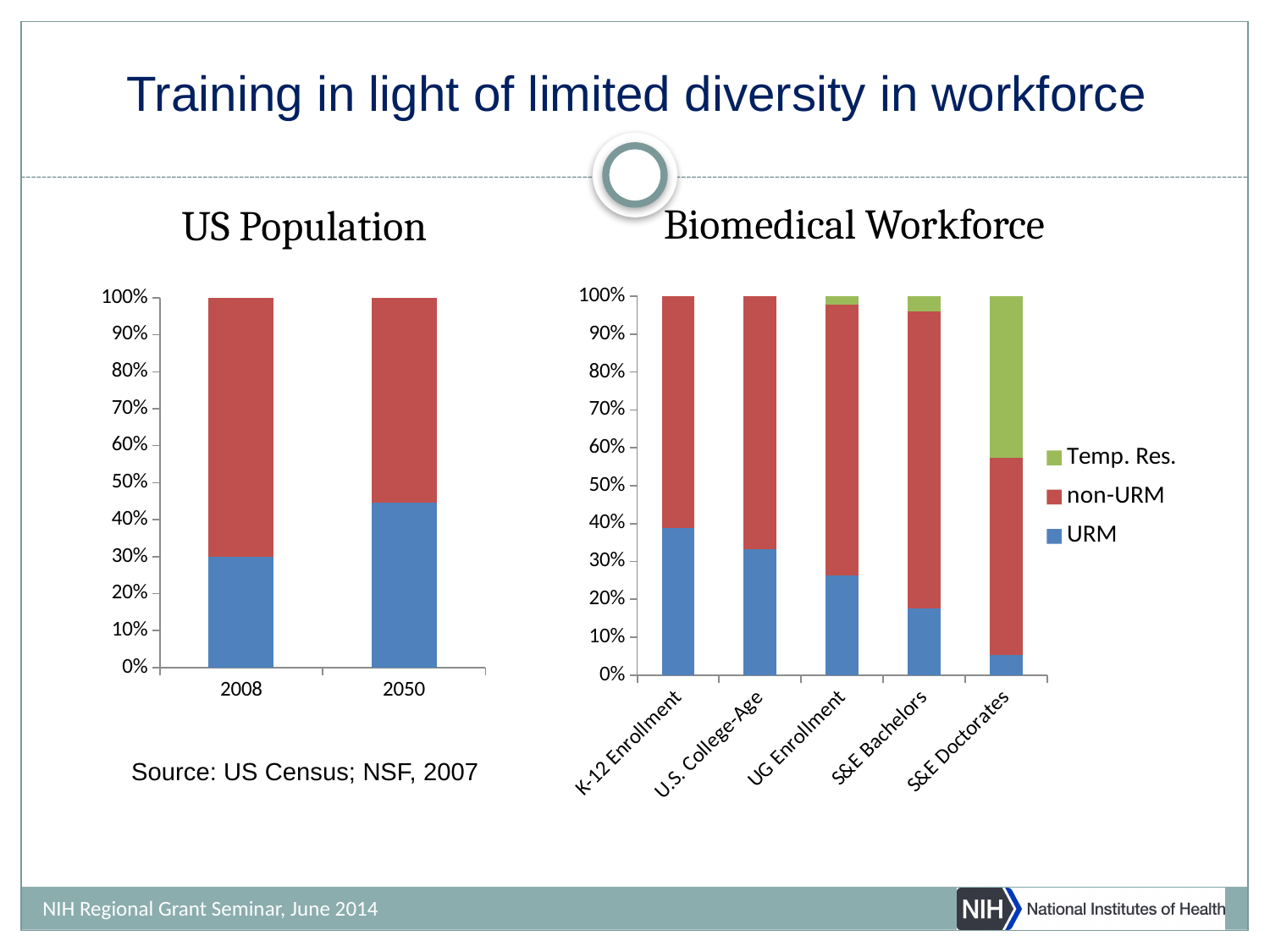
In the Biomedical Workforce chart, which category has the lowest URM share? S&E Doctorates In the US Population chart, which year has the larger URM share, 2008 or 2050? 2050 In the Biomedical Workforce chart, does the URM share rise or fall moving from K-12 Enrollment to S&E Doctorates? fall In the Biomedical Workforce chart, which category has the highest URM share? K-12 Enrollment In the US Population chart, is the URM value for 2050 greater or less than 40%? greater How many series does the legend of the Biomedical Workforce chart list? 3 In the US Population chart, is the URM value for 2008 greater or less than 40%? less How many categories are shown on the x axis of the US Population chart? 2 How many categories are shown on the x axis of the Biomedical Workforce chart? 5 In the Biomedical Workforce chart, which series is shown in green in the legend? Temp. Res. What kind of chart is the US Population chart? bar chart In the Biomedical Workforce chart, is the Temp. Res. value for S&E Doctorates greater or less than 30%? greater